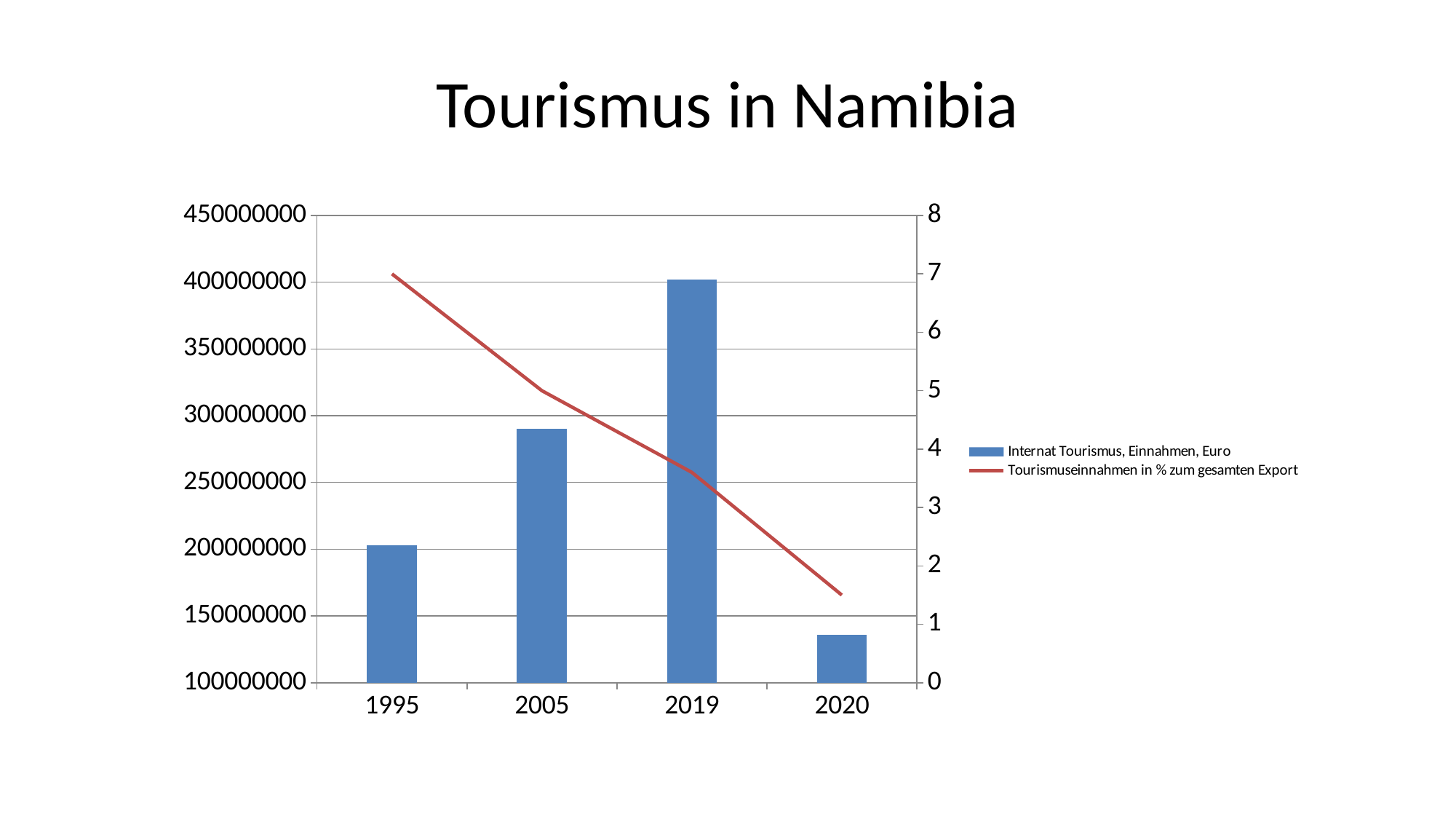
How many years are shown on the x axis? 4 What kind of chart is shown on the slide? A combined bar and line chart Which year has the highest bar for Internat Tourismus, Einnahmen, Euro? 2019 Is the value of Tourismuseinnahmen in % zum gesamten Export in 1995 greater or less than 6? greater How many series does the legend list? 2 Is the bar for Internat Tourismus, Einnahmen, Euro in 2020 greater or less than 150000000? less Which series is drawn as a red line? Tourismuseinnahmen in % zum gesamten Export Which is larger, the Internat Tourismus, Einnahmen, Euro bar for 1995 or for 2005? 2005 Does the line for Tourismuseinnahmen in % zum gesamten Export rise or fall from 1995 to 2020? It falls What is the title of the chart? Tourismus in Namibia Which year has the lowest bar for Internat Tourismus, Einnahmen, Euro? 2020